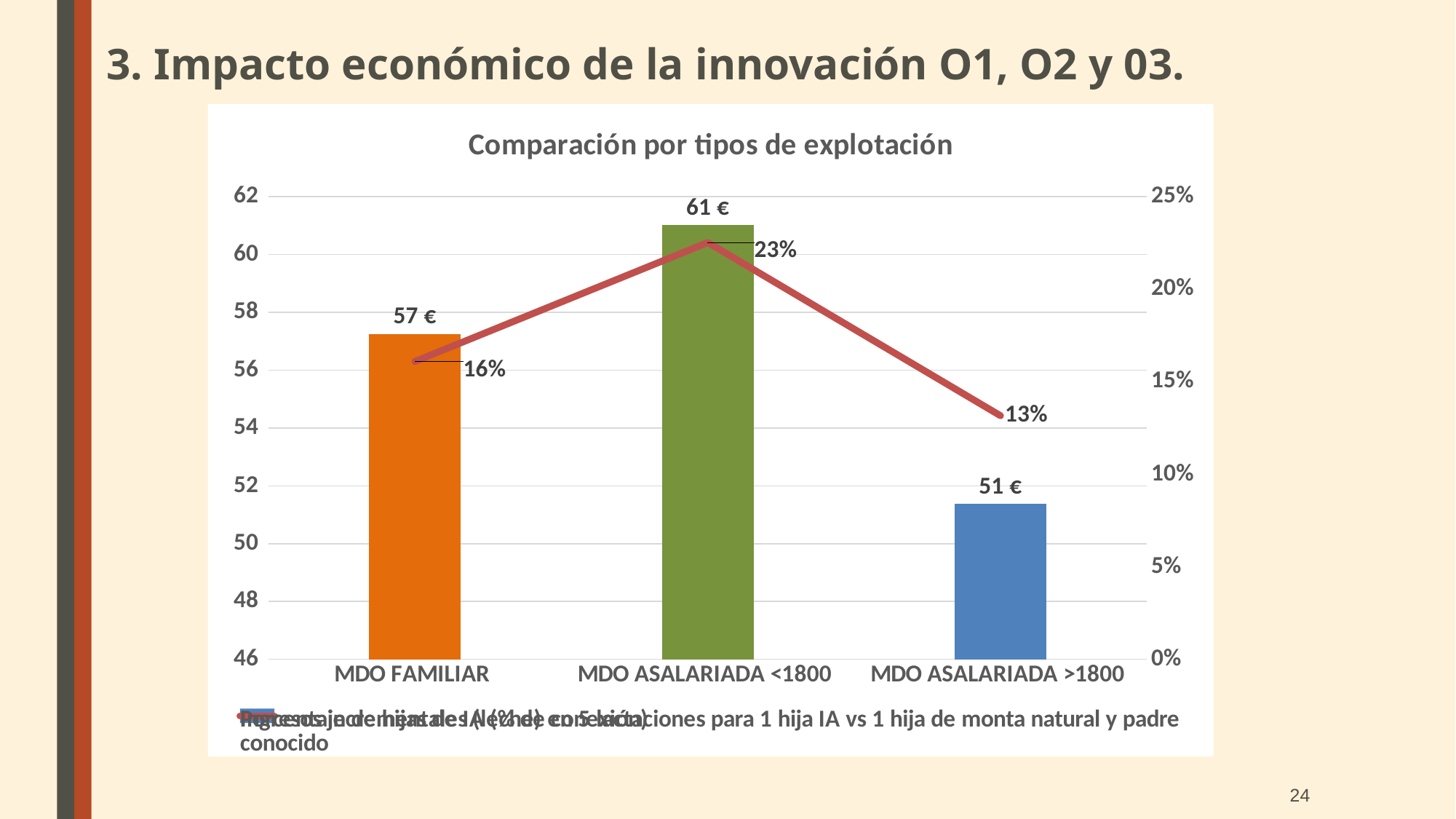
What percentage does the line show for MDO ASALARIADA >1800? 13% What is the title of the chart? Comparación por tipos de explotación What colour is the bar for MDO ASALARIADA <1800? Green What is the difference between the bar values for MDO ASALARIADA <1800 and MDO ASALARIADA >1800? 10 € Which category has the highest bar value? MDO ASALARIADA <1800 Which category has the lowest percentage on the line? MDO ASALARIADA >1800 How many categories are shown on the x axis? 3 What is the bar value for MDO ASALARIADA >1800? 51 € Which is larger, the percentage for MDO FAMILIAR or for MDO ASALARIADA >1800? MDO FAMILIAR What percentage does the line show for MDO ASALARIADA <1800? 23% What is the bar value for MDO FAMILIAR? 57 € What is the bar value for MDO ASALARIADA <1800? 61 €